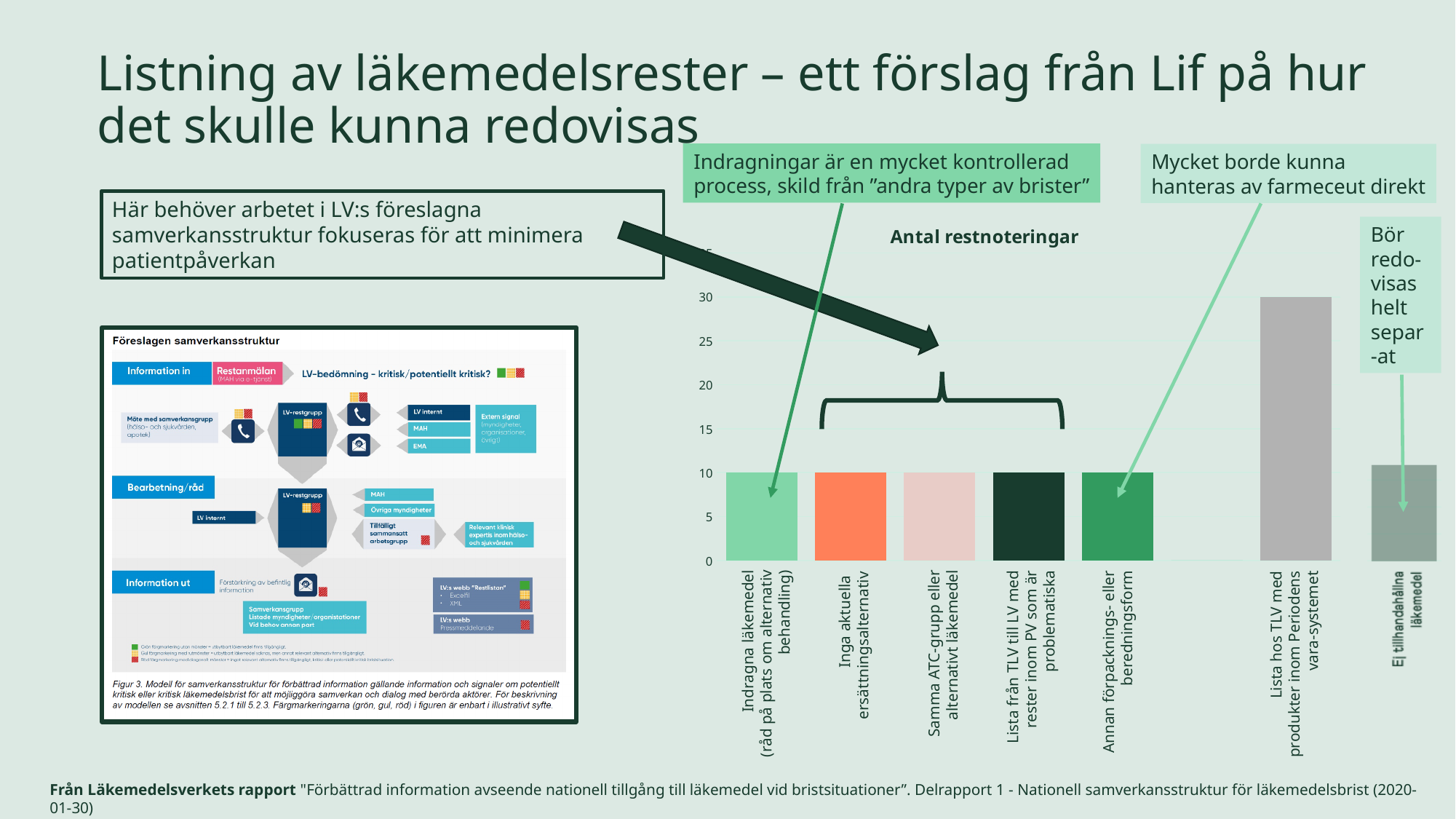
How many categories (bars) does the "Antal restnoteringar" chart show? 7 What is the title of the chart on the right side of the slide? Antal restnoteringar What is the value for "Lista hos TLV med produkter inom Periodens vara-systemet" in the "Antal restnoteringar" chart? 30 What is the value for "Inga aktuella ersättningsalternativ" in the "Antal restnoteringar" chart? 10 In the "Antal restnoteringar" chart, which is larger: the value for "Lista hos TLV med produkter inom Periodens vara-systemet" or the value for "Samma ATC-grupp eller alternativt läkemedel"? Lista hos TLV med produkter inom Periodens vara-systemet In the "Antal restnoteringar" chart, what is the difference between the value for "Lista hos TLV med produkter inom Periodens vara-systemet" and the value for "Annan förpacknings- eller beredningsform"? 20 In the "Antal restnoteringar" chart, is the value for "Indragna läkemedel (råd på plats om alternativ behandling)" greater or less than 15? less What kind of chart is shown under the title "Antal restnoteringar"? bar chart Which category has the highest value in the "Antal restnoteringar" chart? Lista hos TLV med produkter inom Periodens vara-systemet What colour is the bar for "Inga aktuella ersättningsalternativ" in the "Antal restnoteringar" chart? orange In the "Antal restnoteringar" chart, is the value for "Lista hos TLV med produkter inom Periodens vara-systemet" greater or less than 20? greater What is the value for "Ej tillhandahållna läkemedel" in the "Antal restnoteringar" chart? 10